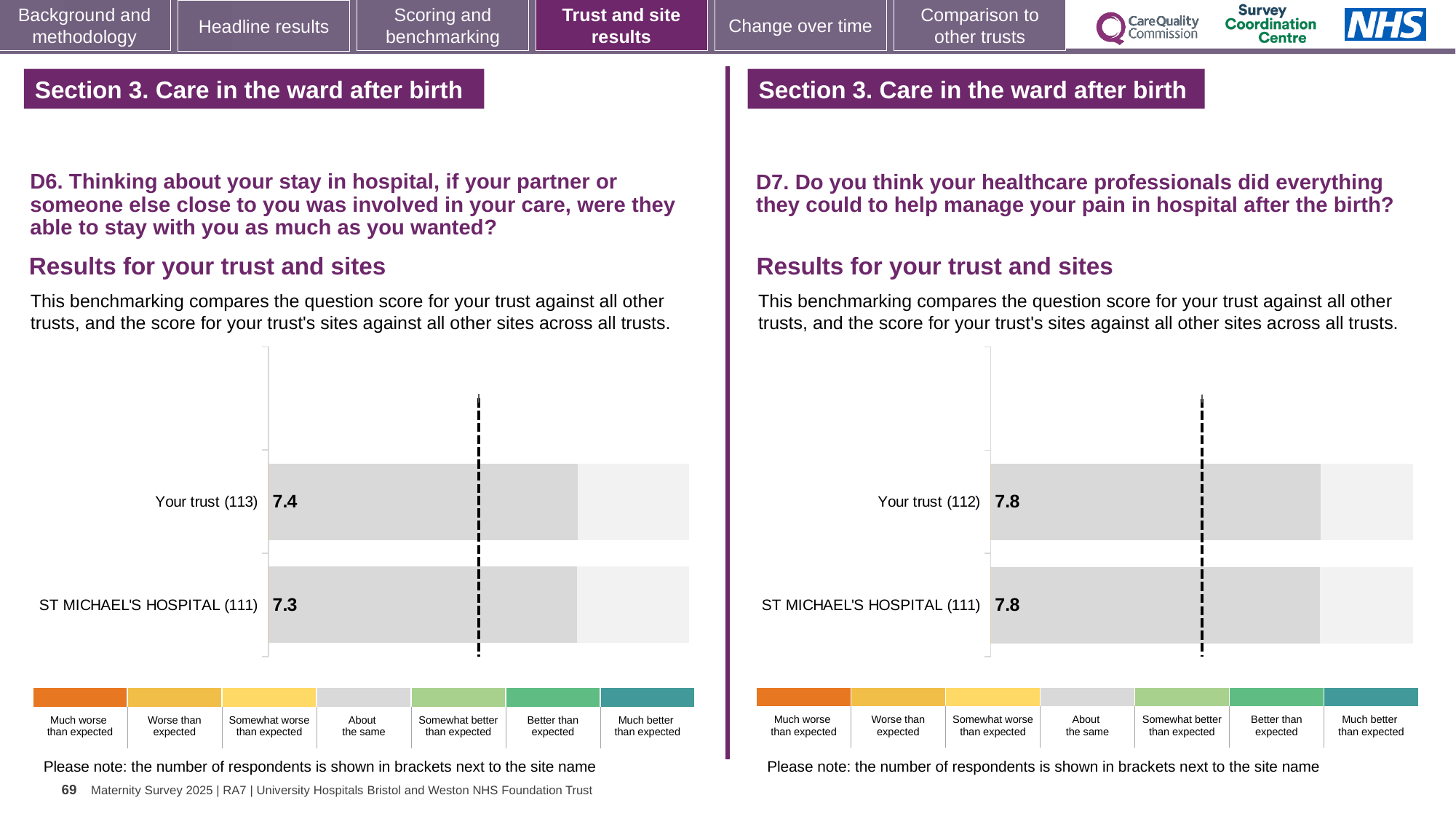
In the D7 chart on the right, what is the score for ST MICHAEL'S HOSPITAL? 7.8 In the D7 chart on the right, how many respondents are shown in brackets for Your trust? 112 In the D6 chart on the left, what is the score for ST MICHAEL'S HOSPITAL? 7.3 In the D6 chart on the left, what is the score for Your trust? 7.4 In the D6 chart on the left, how many respondents are shown in brackets for ST MICHAEL'S HOSPITAL? 111 In the D6 chart on the left, what is the difference between the score for Your trust and the score for ST MICHAEL'S HOSPITAL? 0.1 What kind of chart is used in the D7 chart on the right? Bar chart In the D6 chart on the left, which has the higher score, Your trust or ST MICHAEL'S HOSPITAL? Your trust In the D7 chart on the right, what is the difference between the score for Your trust and the score for ST MICHAEL'S HOSPITAL? 0 How many bars are plotted in the D6 chart on the left? 2 In the D7 chart on the right, what is the score for Your trust? 7.8 In the D6 chart on the left, which category has the lowest score? ST MICHAEL'S HOSPITAL